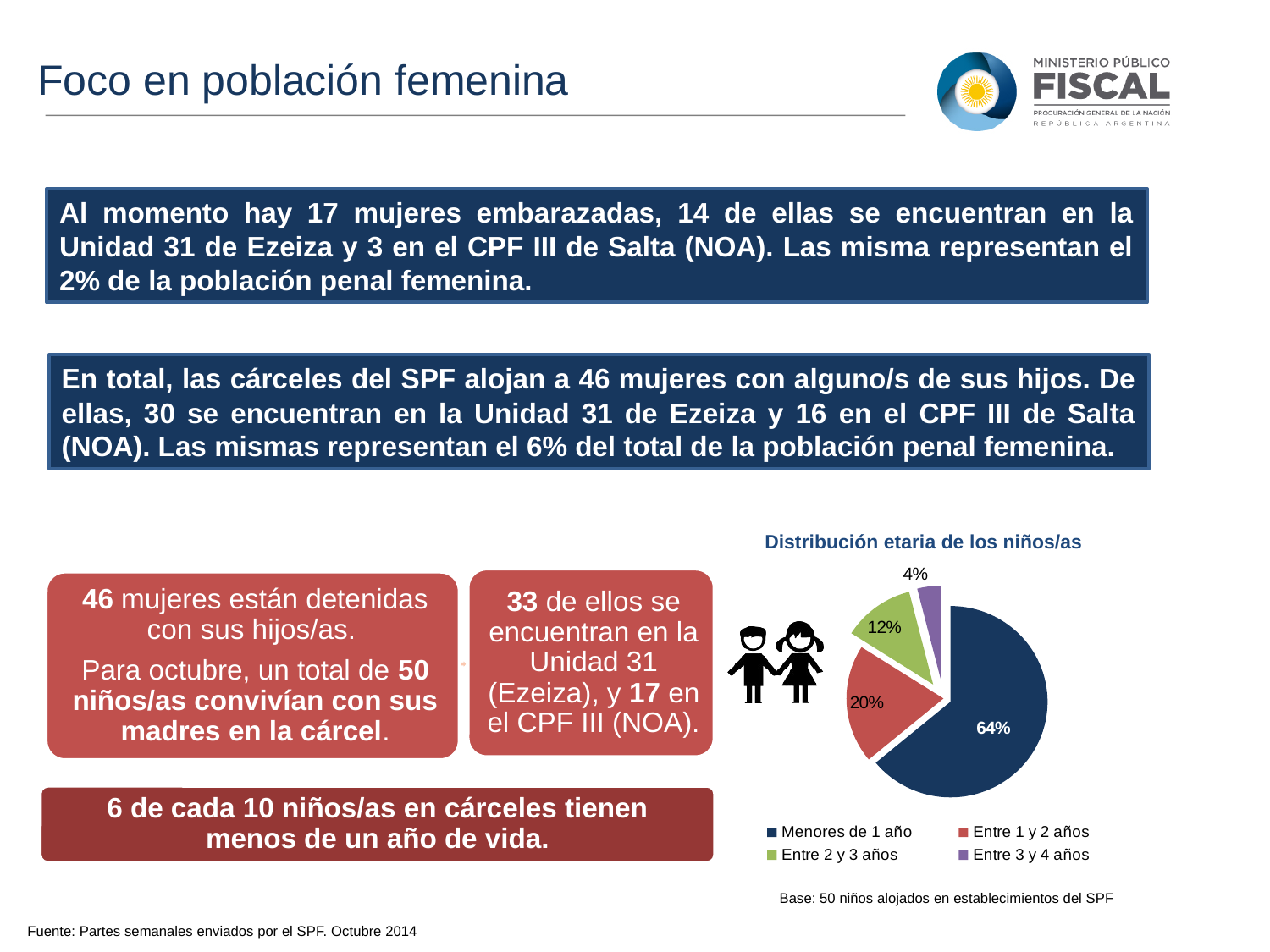
Which is larger in the pie chart, 'Entre 2 y 3 años' or 'Entre 3 y 4 años'? Entre 2 y 3 años What is the value for 'Entre 1 y 2 años' in the pie chart? 20% What is the value for 'Entre 2 y 3 años' in the pie chart? 12% How many categories does the pie chart show? 4 Which category has the smallest slice in the pie chart? Entre 3 y 4 años What is the value for 'Menores de 1 año' in the pie chart? 64% Which category has the largest slice in the pie chart? Menores de 1 año What is the value for 'Entre 3 y 4 años' in the pie chart? 4% What colour is the 'Menores de 1 año' slice in the pie chart? dark blue What is the title of the pie chart? Distribución etaria de los niños/as What is the difference between the 'Menores de 1 año' and 'Entre 1 y 2 años' slices in the pie chart? 44 percentage points What type of chart is shown under the title 'Distribución etaria de los niños/as'? pie chart